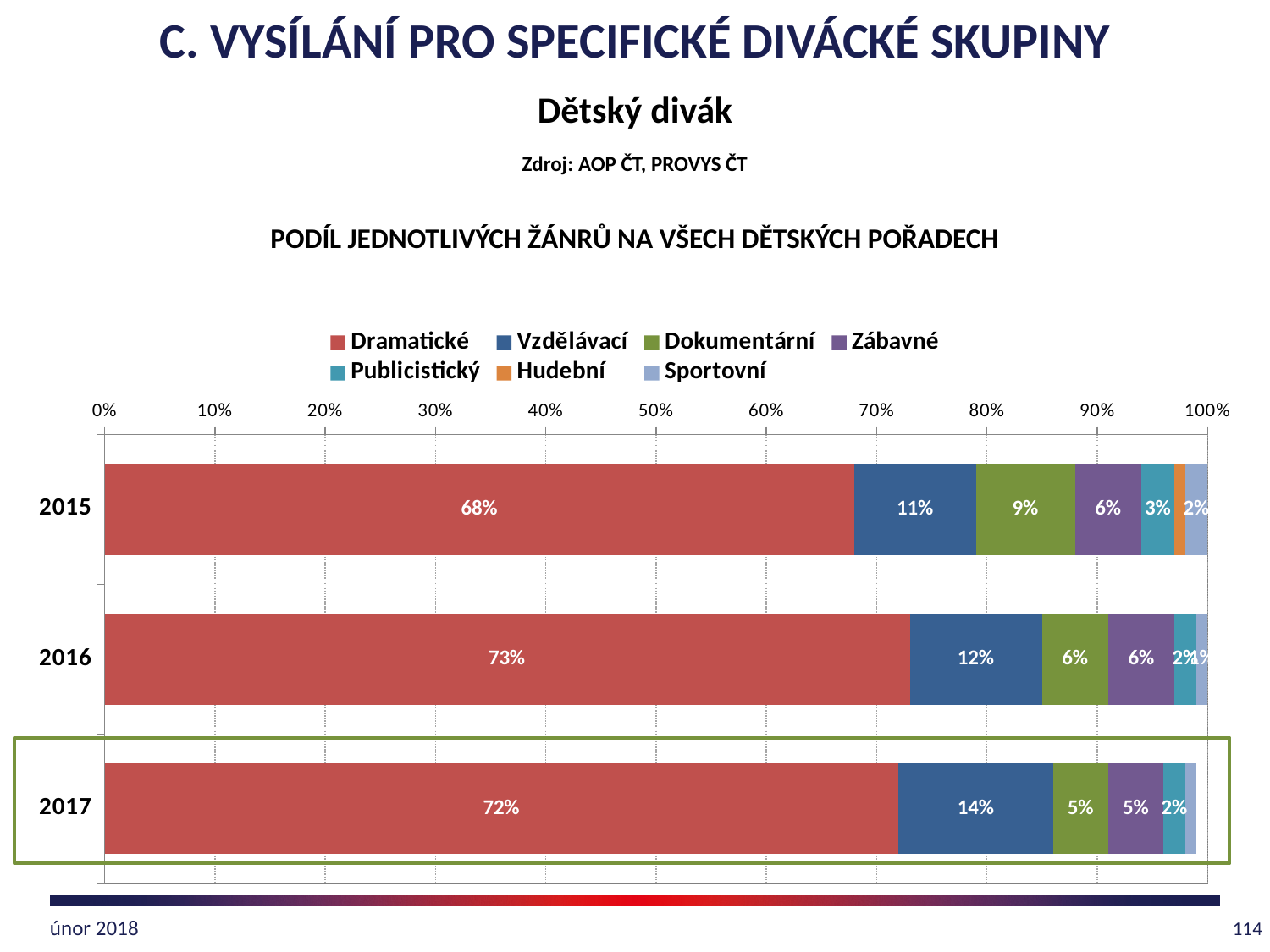
What kind of chart is shown on the slide? stacked bar chart How many years (categories) are plotted on the chart? 3 In which year is the share of Dramatické the highest? 2016 What is the share of Dokumentární in 2016? 6% In which year is the share of Vzdělávací the lowest? 2015 What is the share of Vzdělávací in 2017? 14% What is the share of Zábavné in 2017? 5% Which is larger: the Dokumentární share in 2015 or in 2017? 2015 What is the difference between the Dramatické share in 2016 and in 2015? 5% How many series does the legend list? 7 What is the share of Dramatické in 2015? 68% Which series is shown in red on the chart? Dramatické